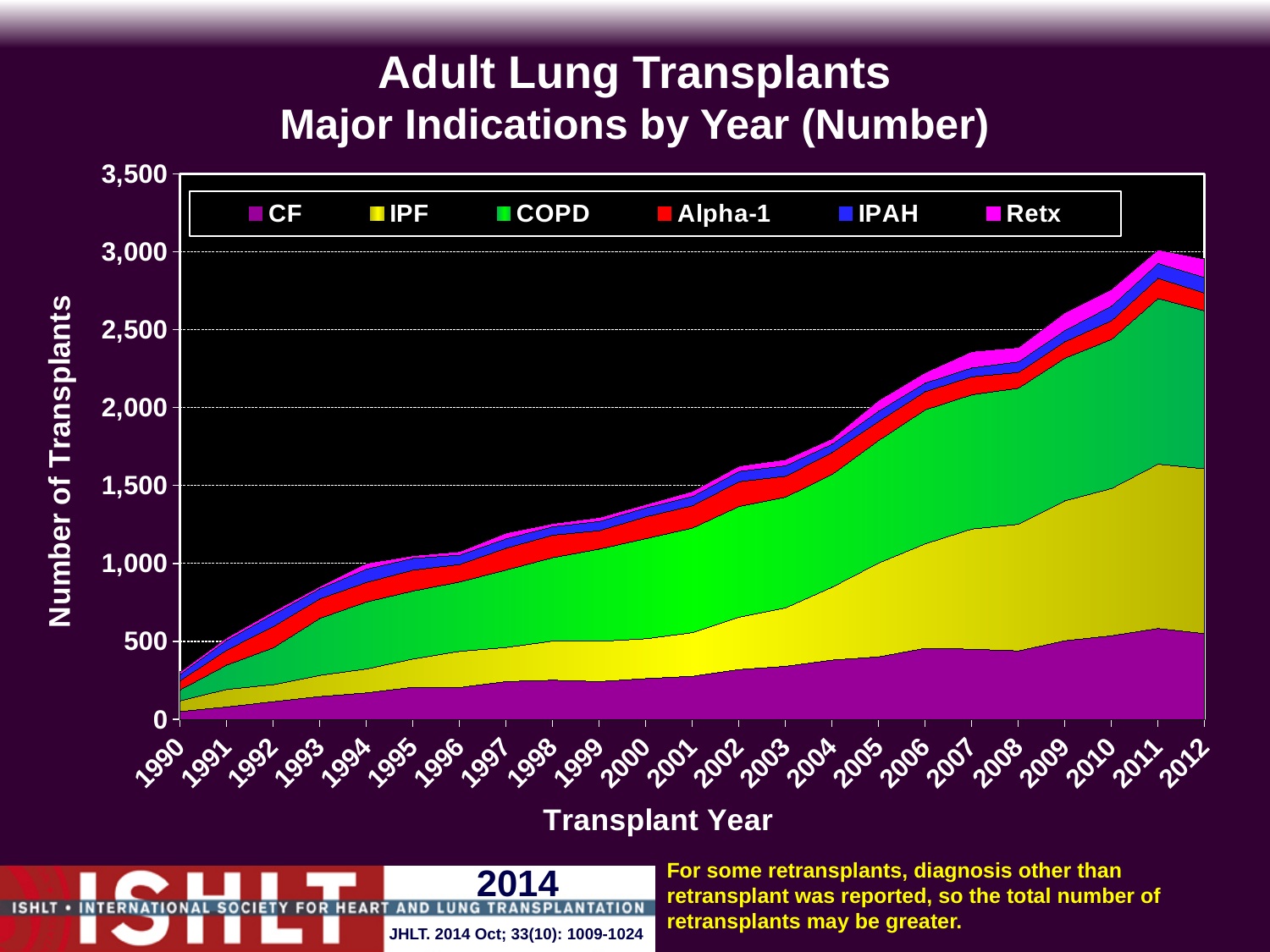
Is the total number of transplants in 2000 greater or less than 1,000? greater Which series is shown in green in the legend? COPD How many series does the legend list? 6 What kind of chart is shown on the slide? Stacked area chart Does the total number of transplants generally rise or fall from 1990 to 2012? Rise Is the total number of transplants in 2006 greater or less than 2,000? greater Which year has the lowest total number of transplants? 1990 What is the title of the y axis? Number of Transplants Is the total number of transplants in 1990 greater or less than 500? less How many transplant years are plotted along the x axis? 23